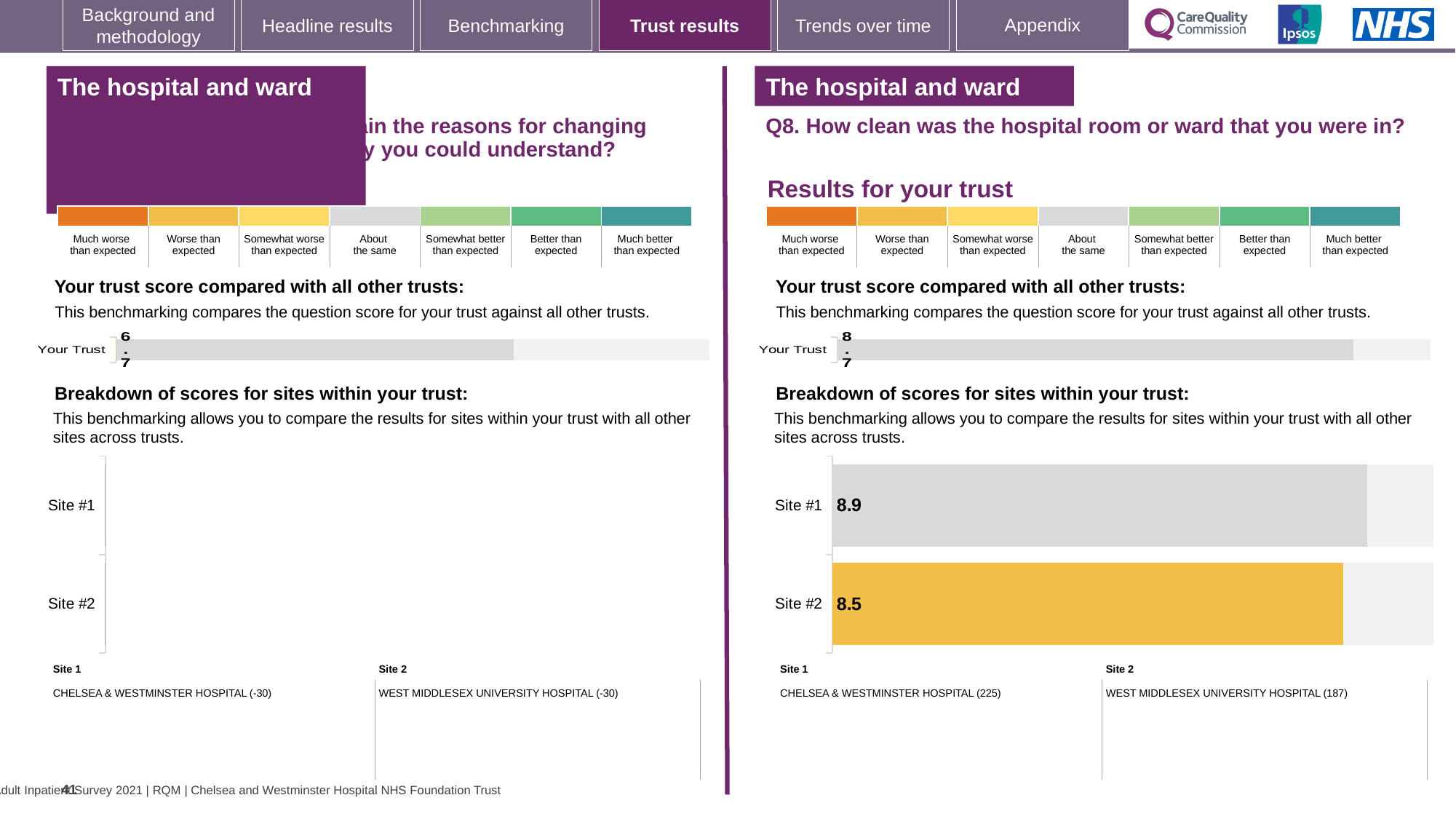
How many sites are shown on the right-hand Q8 site breakdown chart? 2 On the right-hand chart for Q8 (how clean was the hospital room or ward), what is the score for Site #1? 8.9 What kind of chart is the right-hand Q8 site breakdown chart? bar chart On the left-hand 'Your trust score compared with all other trusts' chart, what is the score for Your Trust? 6.7 On the right-hand chart for Q8 (how clean was the hospital room or ward), what is the score for Site #2? 8.5 On the right-hand 'Your trust score compared with all other trusts' chart for Q8, what is the score for Your Trust? 8.7 On the right-hand Q8 site breakdown chart, which site has the higher score? Site #1 On the right-hand Q8 site breakdown chart, is the score for Site #1 larger or smaller than the score for Site #2? larger On the right-hand Q8 site breakdown chart, what colour is the bar for Site #2? yellow Comparing the two 'Your Trust' score charts, is the trust score on the right-hand (Q8) chart larger or smaller than the trust score on the left-hand chart? larger On the right-hand Q8 site breakdown chart, what is the difference between the Site #1 and Site #2 scores? 0.4 On the right-hand Q8 site breakdown chart, which site has the lower score? Site #2